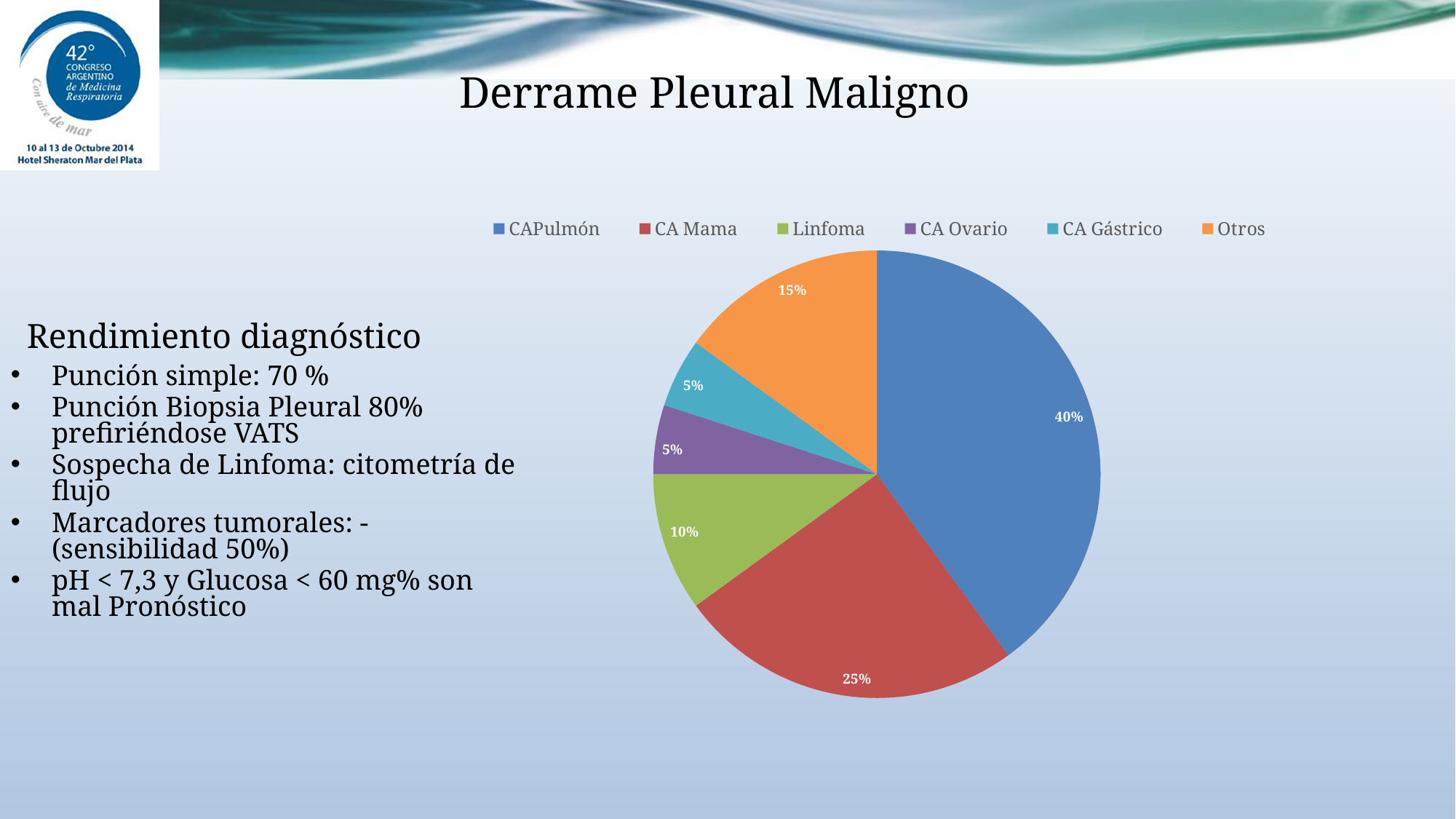
What share of the pie does Otros represent? 15% Which is larger, the Otros slice or the Linfoma slice? Otros What share of the pie does CA Ovario represent? 5% What share of the pie does Linfoma represent? 10% What is the difference between the CAPulmón and CA Mama shares? 15% What share of the pie does CAPulmón represent? 40% What colour is the CA Mama slice in the pie chart? red What is the combined share of CA Ovario and CA Gástrico? 10% Which category has the largest slice of the pie? CAPulmón How many categories does the legend of the pie chart list? 6 What share of the pie does CA Mama represent? 25% What type of chart is shown on the slide? pie chart